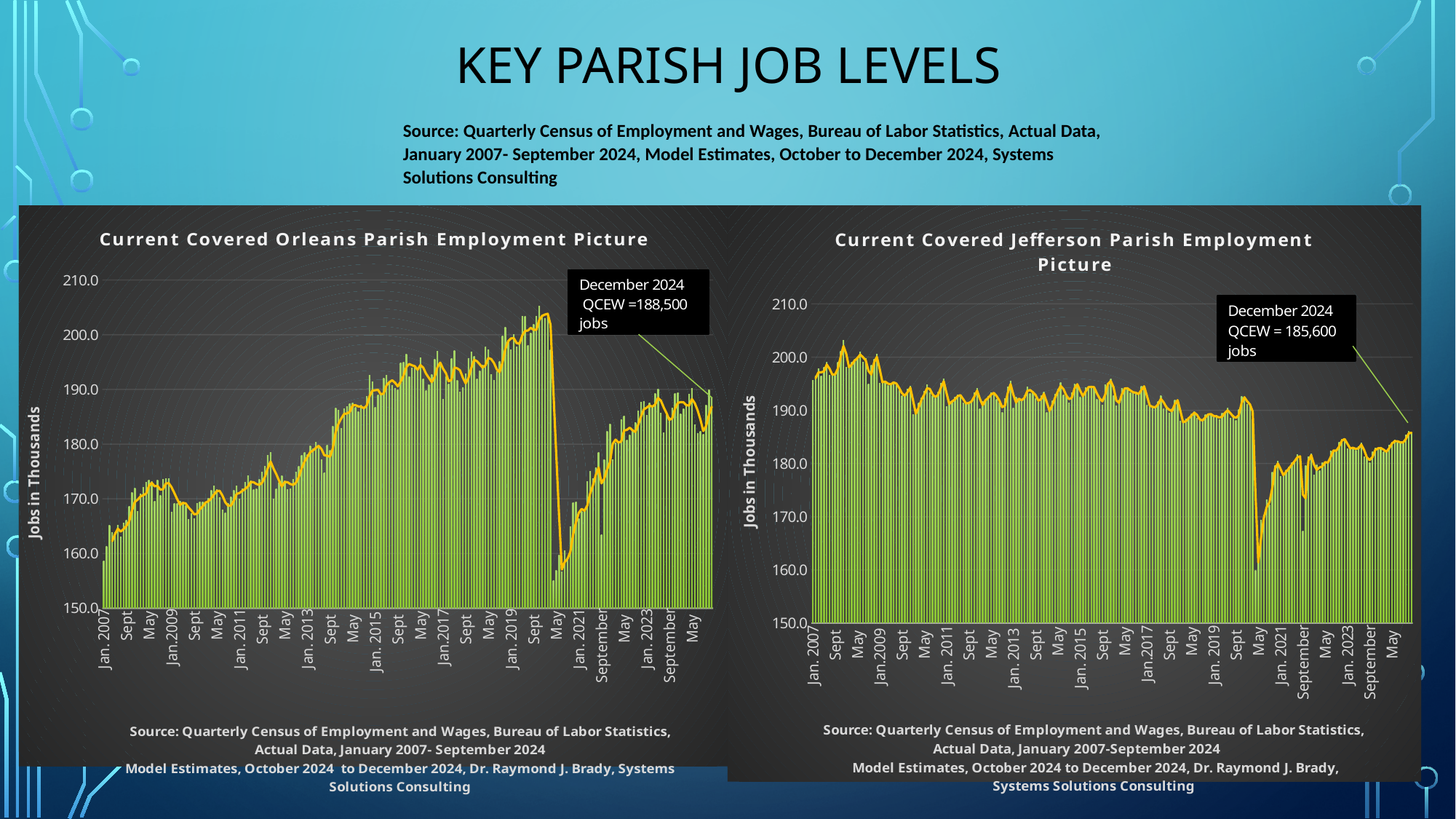
On the Current Covered Jefferson Parish Employment Picture chart, is the lowest value around May 2020 greater or less than 170.0? less On the Current Covered Orleans Parish Employment Picture chart, do the values generally rise or fall from Jan. 2007 to the end of 2019? rise What is the title of the vertical axis on the Current Covered Orleans Parish Employment Picture chart? Jobs in Thousands On the Current Covered Orleans Parish Employment Picture chart, what is the December 2024 QCEW job level shown in the annotation? 188,500 jobs What kind of chart is the Current Covered Jefferson Parish Employment Picture chart? bar chart with a line overlay What is the difference between the December 2024 job levels annotated on the Orleans Parish chart and the Jefferson Parish chart? 2,900 jobs On the Current Covered Jefferson Parish Employment Picture chart, what is the December 2024 QCEW job level shown in the annotation? 185,600 jobs On the Current Covered Jefferson Parish Employment Picture chart, is the value for Jan. 2007 greater or less than 190.0? greater How many charts are shown on the slide? 2 On the Current Covered Orleans Parish Employment Picture chart, is the value for Jan. 2007 greater or less than 170.0? less Comparing the December 2024 annotations, which parish has the higher job level, Orleans or Jefferson? Orleans